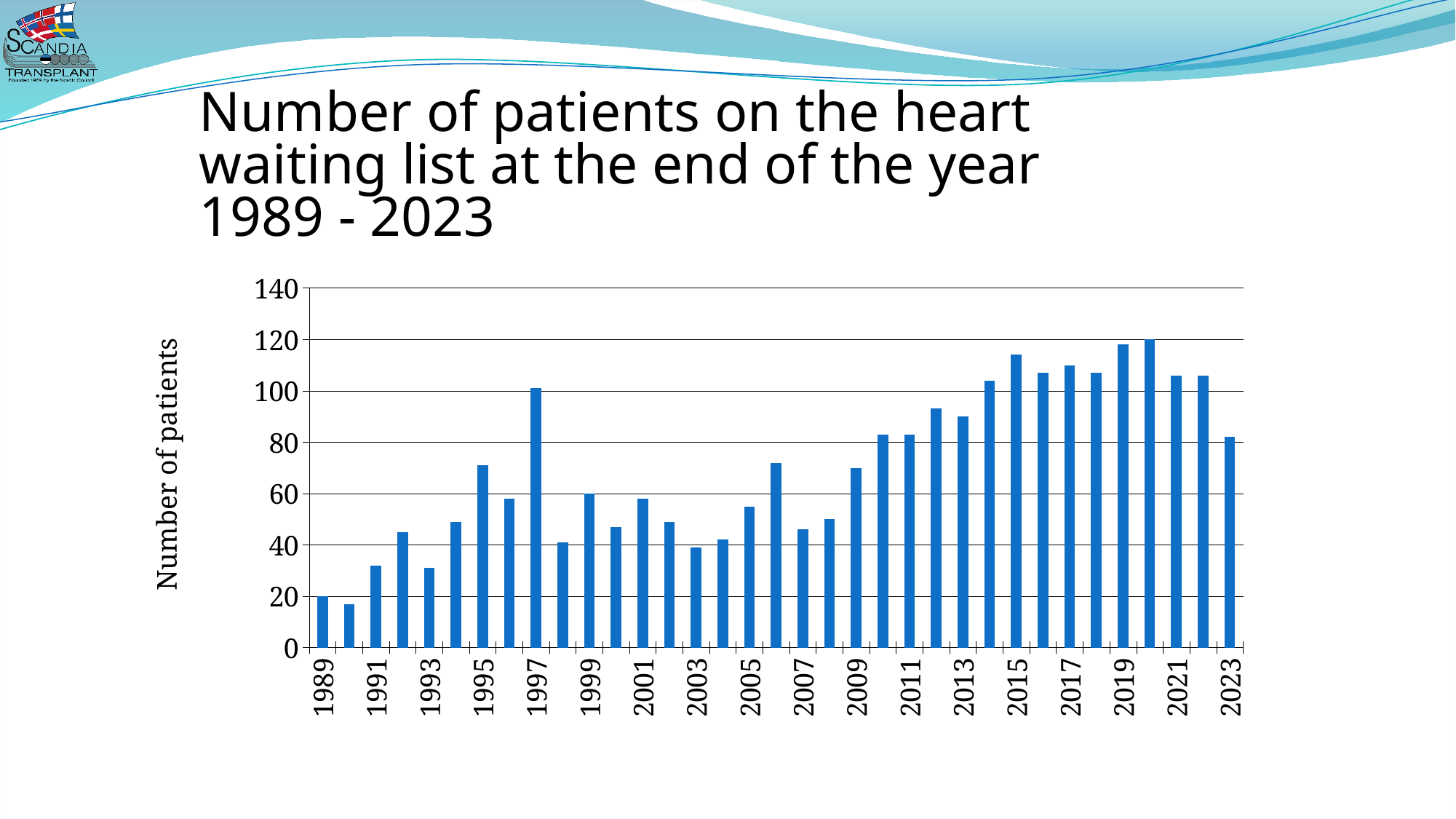
Is the value for 2003 greater or less than 60? less Is the value for 2006 greater or less than 60? greater What is the label of the vertical axis? Number of patients Is the value for 2023 greater or less than 100? less Which year has the larger value, 2015 or 2005? 2015 Do the values generally rise or fall from 2009 to 2020? rise What is the title of the slide's chart? Number of patients on the heart waiting list at the end of the year 1989 - 2023 What kind of chart is shown on the slide? bar chart How many years (bars) are plotted in the chart? 35 Which year has the larger value, 1997 or 1998? 1997